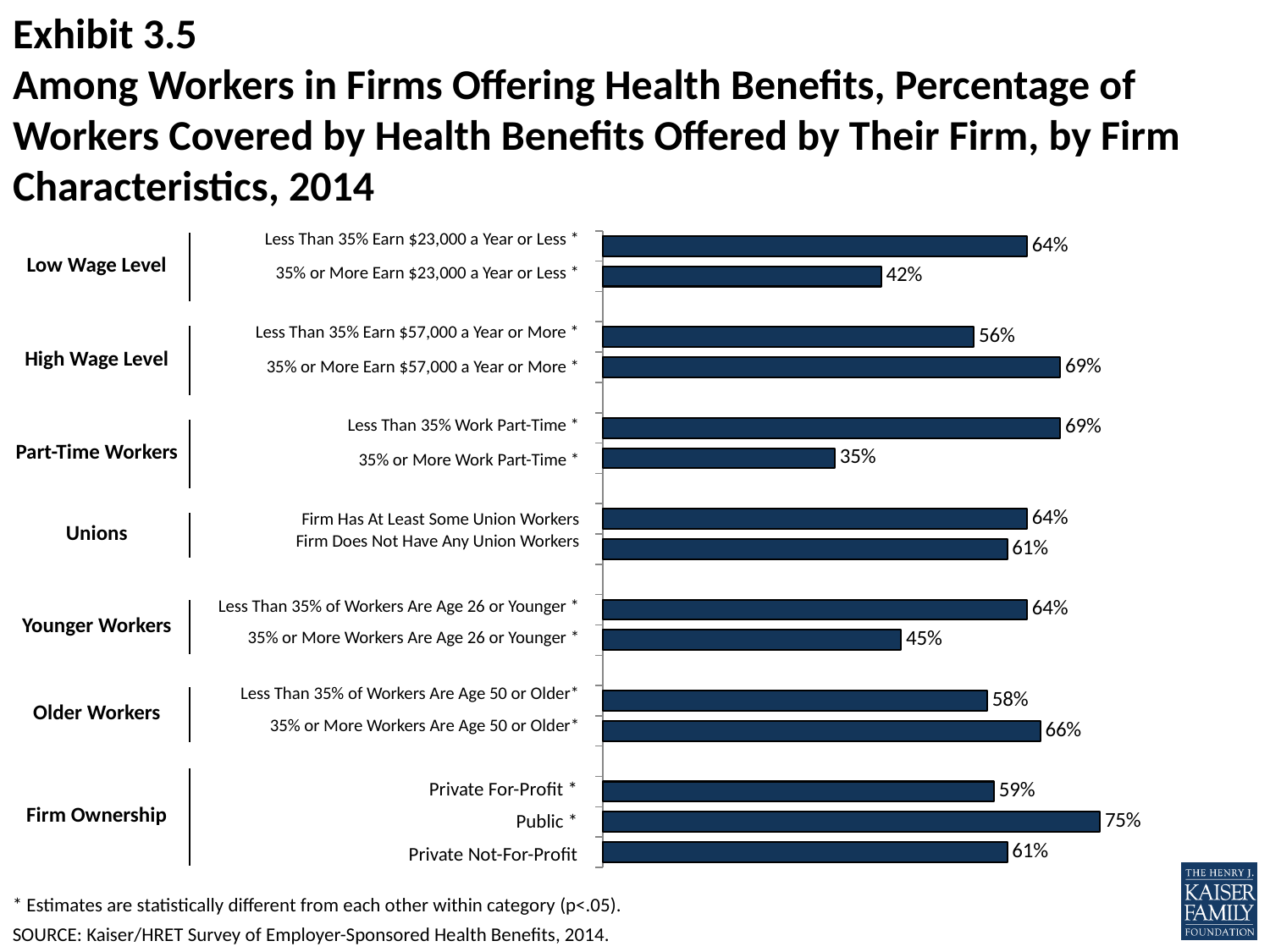
Which category has the lowest percentage of workers covered? 35% or More Work Part-Time What is the difference between the values for Public and Private For-Profit firms? 16 percentage points What is the value for Public firms under Firm Ownership? 75% How many firm characteristic groups are labeled along the left side of the chart? 7 How many bars are plotted in the chart? 15 What is the value for firms that do not have any union workers? 61% What percentage of workers are covered by health benefits in firms where 35% or more earn $23,000 a year or less? 42% What kind of chart is shown on the slide? Bar chart What is the difference between the values for Less Than 35% Work Part-Time and 35% or More Work Part-Time? 34 percentage points Which category has the highest percentage of workers covered? Public Which is larger: the value for Less Than 35% of Workers Are Age 50 or Older, or 35% or More Workers Are Age 50 or Older? 35% or More Workers Are Age 50 or Older What is the value for firms where 35% or more work part-time? 35%